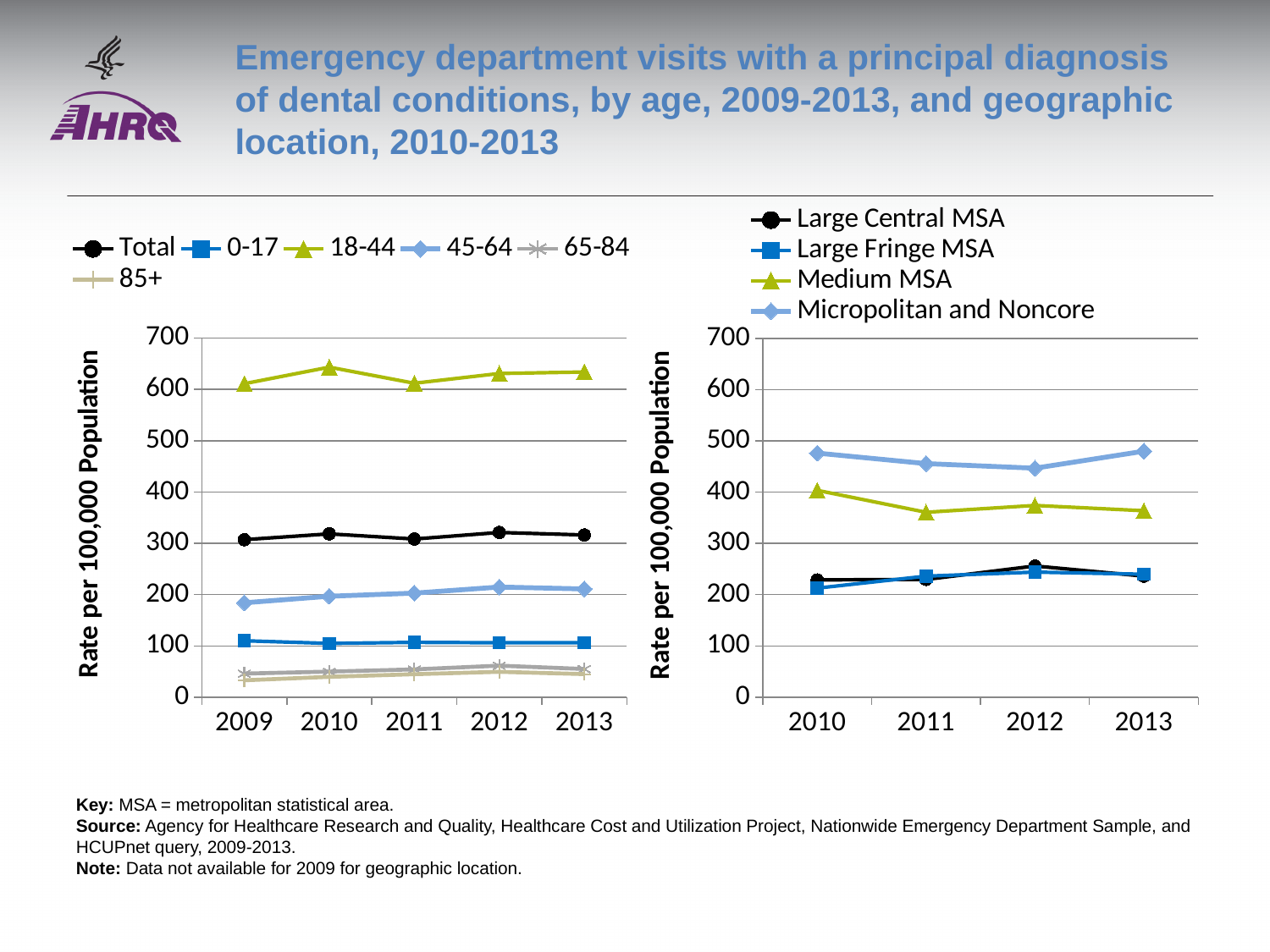
In the left chart (by age), which age group has the lowest rate across all years? 85+ In the right chart (by geographic location), which location has the highest rate across all years? Micropolitan and Noncore In the right chart (by geographic location), which is larger in 2013: Medium MSA or Micropolitan and Noncore? Micropolitan and Noncore What kind of chart is the left chart (by age)? line chart How many series does the legend of the right chart (by geographic location) list? 4 In the left chart (by age), is the value for 0-17 in 2013 greater or less than 200? less In the left chart (by age), is the value for 18-44 in 2010 greater or less than 600? greater How many years are plotted on the x axis of the right chart (by geographic location)? 4 In the right chart (by geographic location), is the value for Micropolitan and Noncore in 2010 greater or less than 500? less What is the y-axis label of the left chart (by age)? Rate per 100,000 Population In the left chart (by age), which age group has the highest rate across all years? 18-44 How many series does the legend of the left chart (by age) list? 6